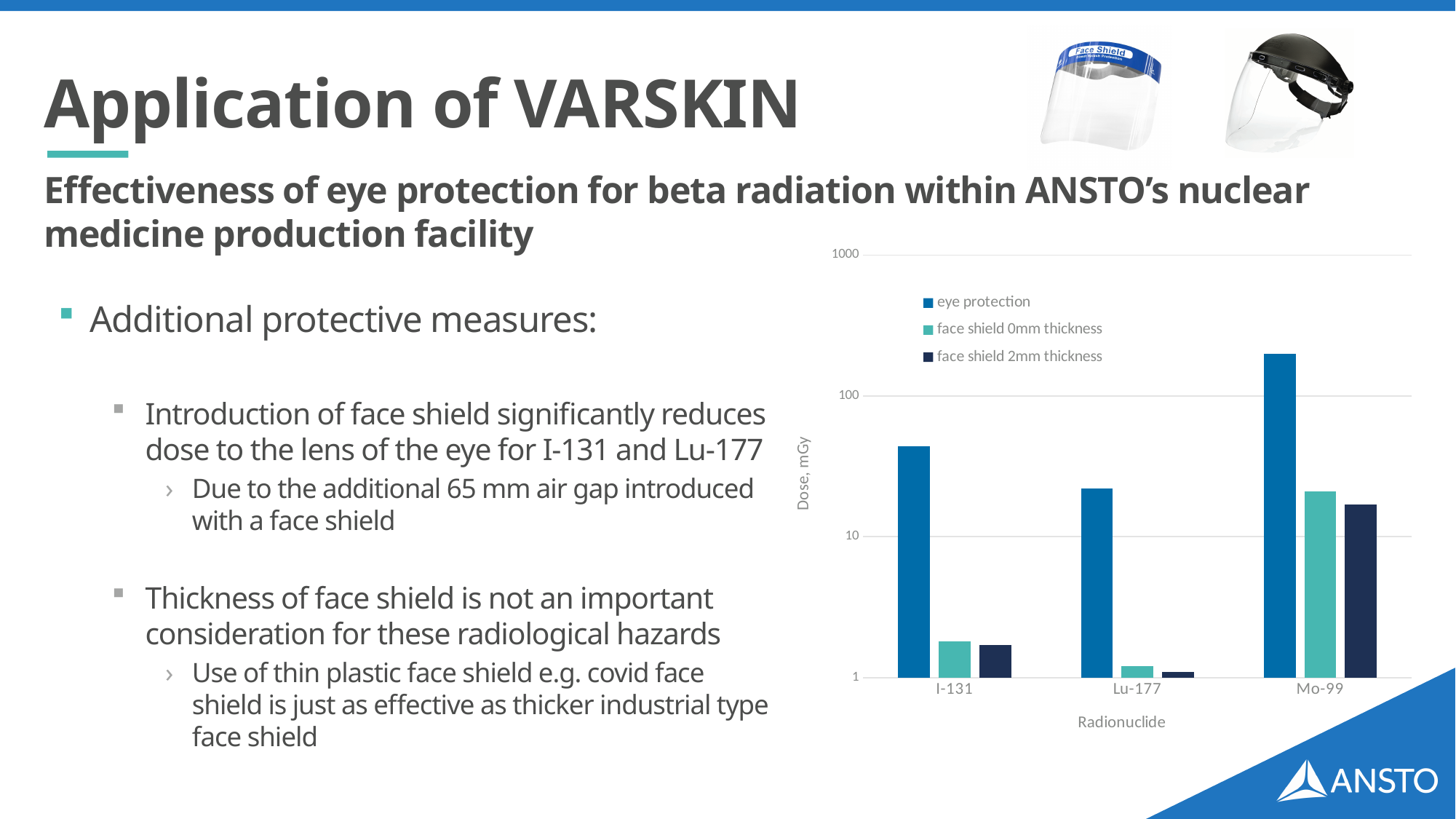
Which radionuclide has the lowest dose for the eye protection series? Lu-177 Which has the larger eye protection dose, I-131 or Lu-177? I-131 Is the face shield 0mm thickness dose for I-131 greater or less than 10? less How many series does the chart's legend list? 3 Is the eye protection dose for I-131 greater or less than 100? less What kind of chart is shown on the slide? bar chart Is the eye protection dose for Mo-99 greater or less than 100? greater For Mo-99, which is larger: the face shield 0mm thickness dose or the face shield 2mm thickness dose? face shield 0mm thickness What is the label of the chart's vertical axis? Dose, mGy How many radionuclides are shown on the x axis of the chart? 3 Which radionuclide has the highest dose for the eye protection series? Mo-99